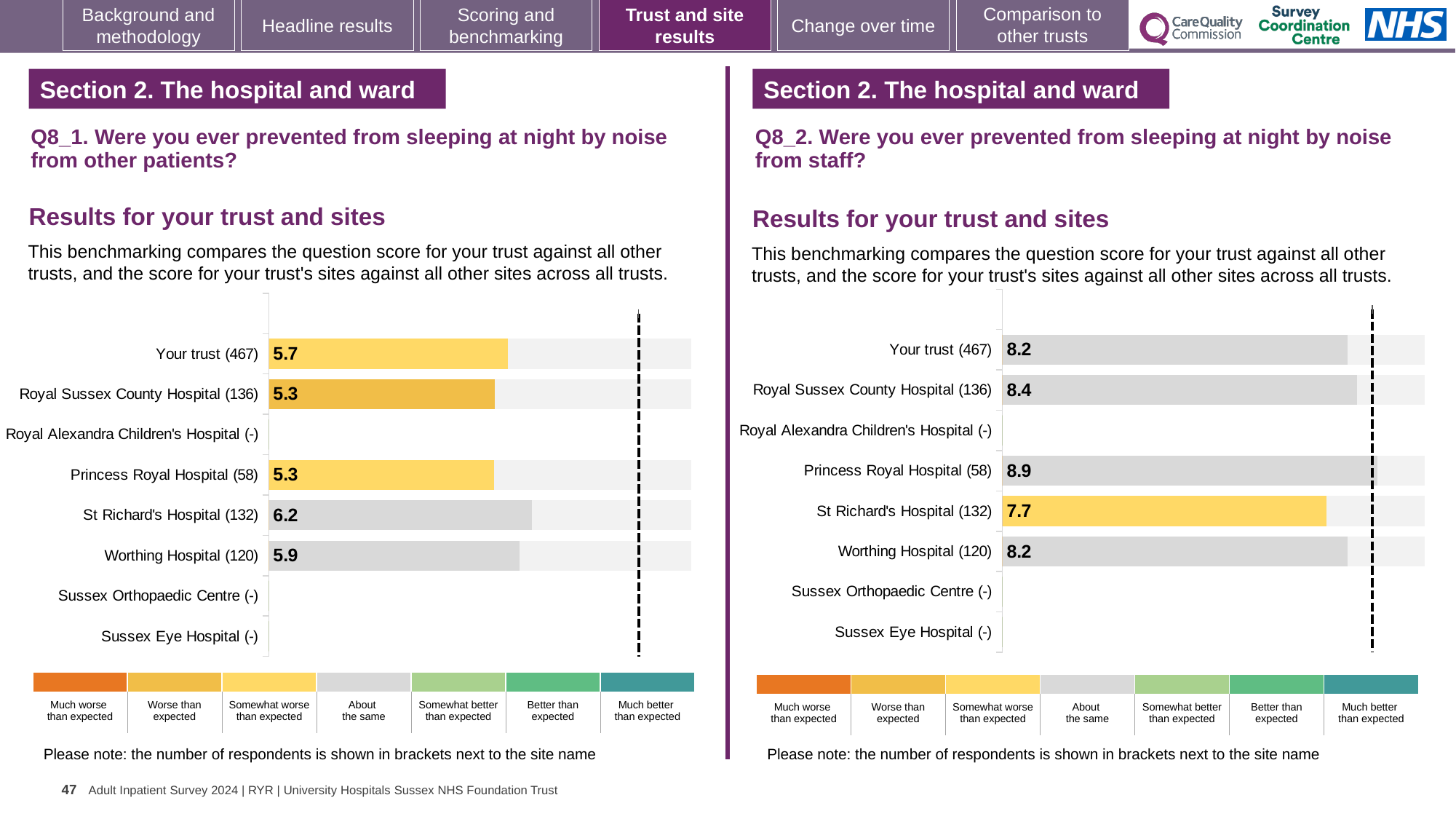
On the Q8_2 chart (noise from staff), how many sites have a score bar plotted? 5 On the Q8_2 chart (noise from staff), what is the difference between the scores for Princess Royal Hospital and St Richard's Hospital? 1.2 What type of chart is used on the Q8_1 chart (noise from other patients)? Bar chart On the Q8_1 chart (noise from other patients), which is larger: the score for Your trust or the score for Royal Sussex County Hospital? Your trust On the Q8_1 chart (noise from other patients), what is the score for Your trust (467)? 5.7 On the Q8_1 chart (noise from other patients), what is the difference between the scores for St Richard's Hospital and Worthing Hospital? 0.3 On the Q8_2 chart (noise from staff), what is the score for Princess Royal Hospital (58)? 8.9 On the Q8_2 chart (noise from staff), how many categories are listed on the vertical axis? 8 On the Q8_2 chart (noise from staff), which site has the lowest score? St Richard's Hospital (132) On the Q8_1 chart (noise from other patients), which site has the highest score? St Richard's Hospital (132) On the Q8_1 chart (noise from other patients), what is the score for St Richard's Hospital (132)? 6.2 On the Q8_2 chart (noise from staff), what is the score for Worthing Hospital (120)? 8.2